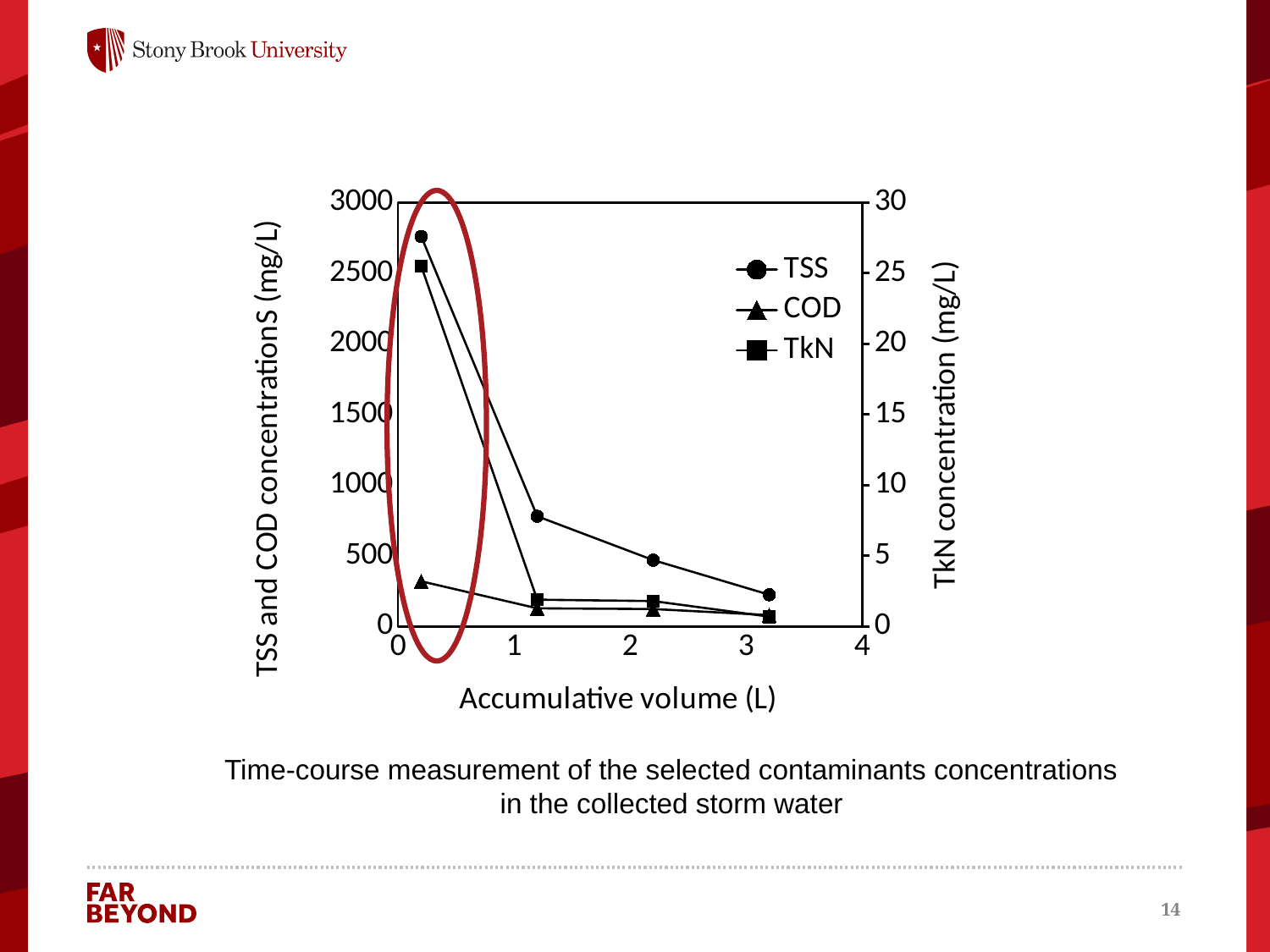
Which series has the highest value on the left axis (TSS and COD concentrations)? TSS What is the title of the x axis? Accumulative volume (L) Is the first TkN value (at the lowest accumulative volume) greater or less than 20 mg/L on the right axis? greater How many series does the legend list? 3 Does the TSS concentration rise or fall as accumulative volume increases? fall What kind of chart is shown on the slide? line chart At the lowest accumulative volume, which is larger on the left axis: TSS or COD? TSS Is the first COD value (at the lowest accumulative volume) greater or less than 500 mg/L? less Is the first TSS value (at the lowest accumulative volume) greater or less than 2500 mg/L? greater Does the COD concentration rise or fall as accumulative volume increases? fall How many data points are plotted for the TSS series? 4